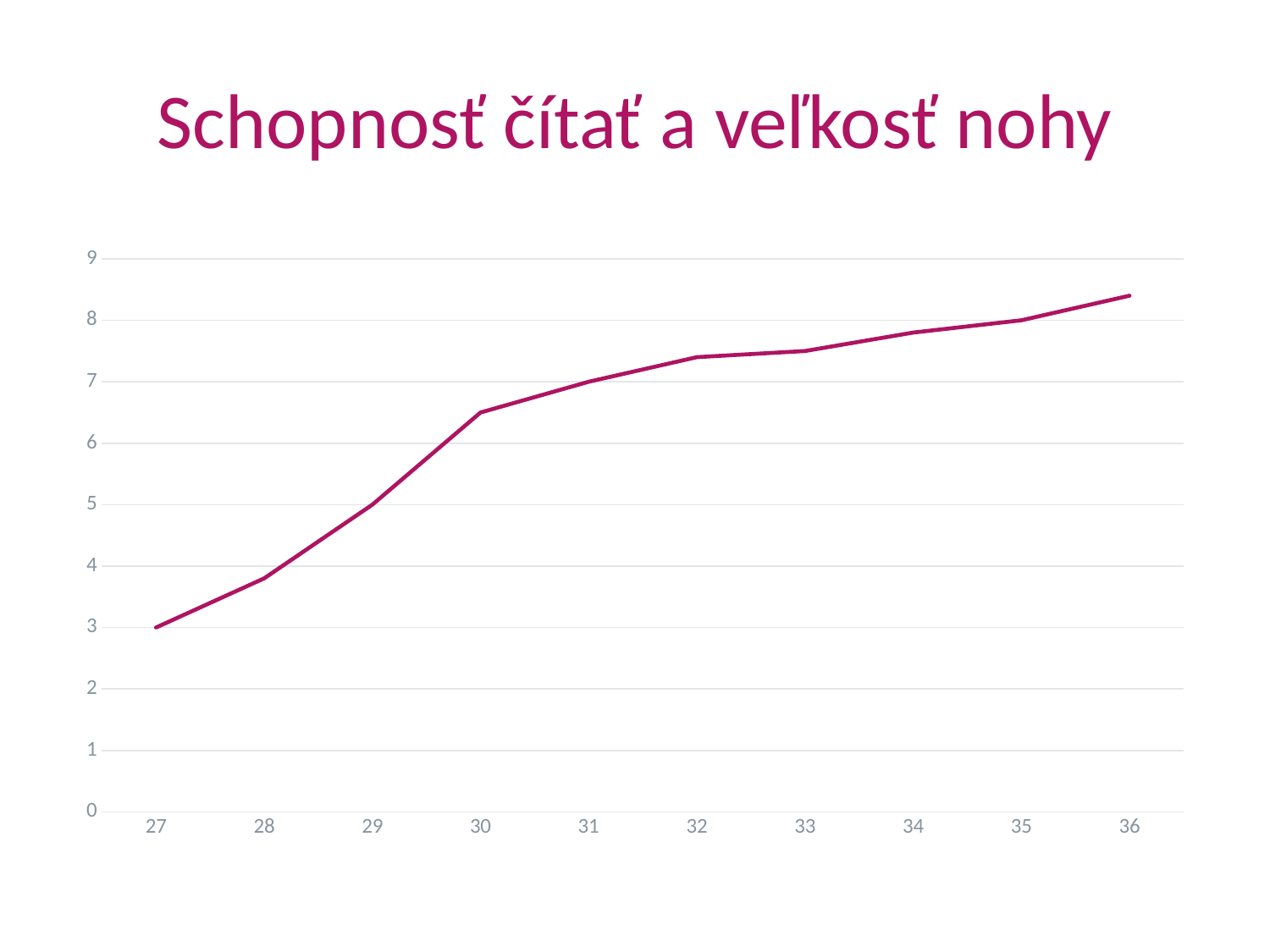
At which x-axis value is the line highest? 36 What is the value at 29? 5 How many points are plotted on the line? 10 Which has the larger value, 30 or 28? 30 What is the title of the chart? Schopnosť čítať a veľkosť nohy Is the value at 36 greater or less than 8? greater Is the value at 28 greater or less than 4? less At which x-axis value is the line lowest? 27 Do the values rise or fall as the x axis goes from 27 to 36? rise What kind of chart is shown on the slide? line chart What is the value at 27? 3 Is the value at 30 greater or less than 6? greater